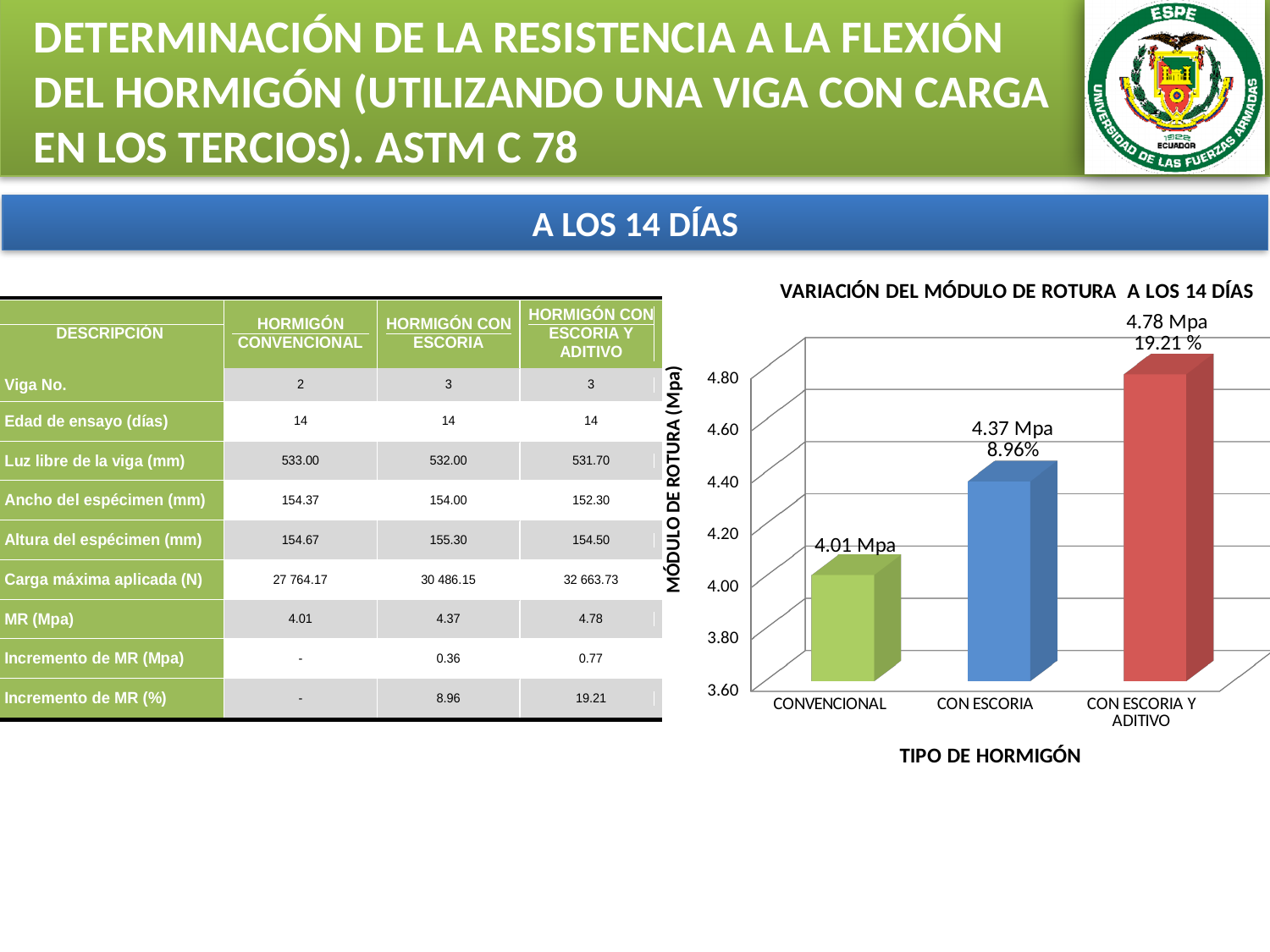
What is the value for CONVENCIONAL in the chart? 4.01 Mpa Which type of concrete has the highest módulo de rotura in the chart? CON ESCORIA Y ADITIVO What is the value for CON ESCORIA in the chart? 4.37 Mpa Is the value for CON ESCORIA greater or less than 4.20? greater What is the difference between the values for CON ESCORIA and CONVENCIONAL? 0.36 Mpa What is the title of the chart? VARIACIÓN DEL MÓDULO DE ROTURA A LOS 14 DÍAS What kind of chart is shown on the slide? bar chart Which type of concrete has the lowest módulo de rotura in the chart? CONVENCIONAL Which is larger, the value for CON ESCORIA or the value for CONVENCIONAL? CON ESCORIA How many types of concrete are shown in the chart? 3 What is the difference between the values for CON ESCORIA Y ADITIVO and CONVENCIONAL? 0.77 Mpa What is the value for CON ESCORIA Y ADITIVO in the chart? 4.78 Mpa